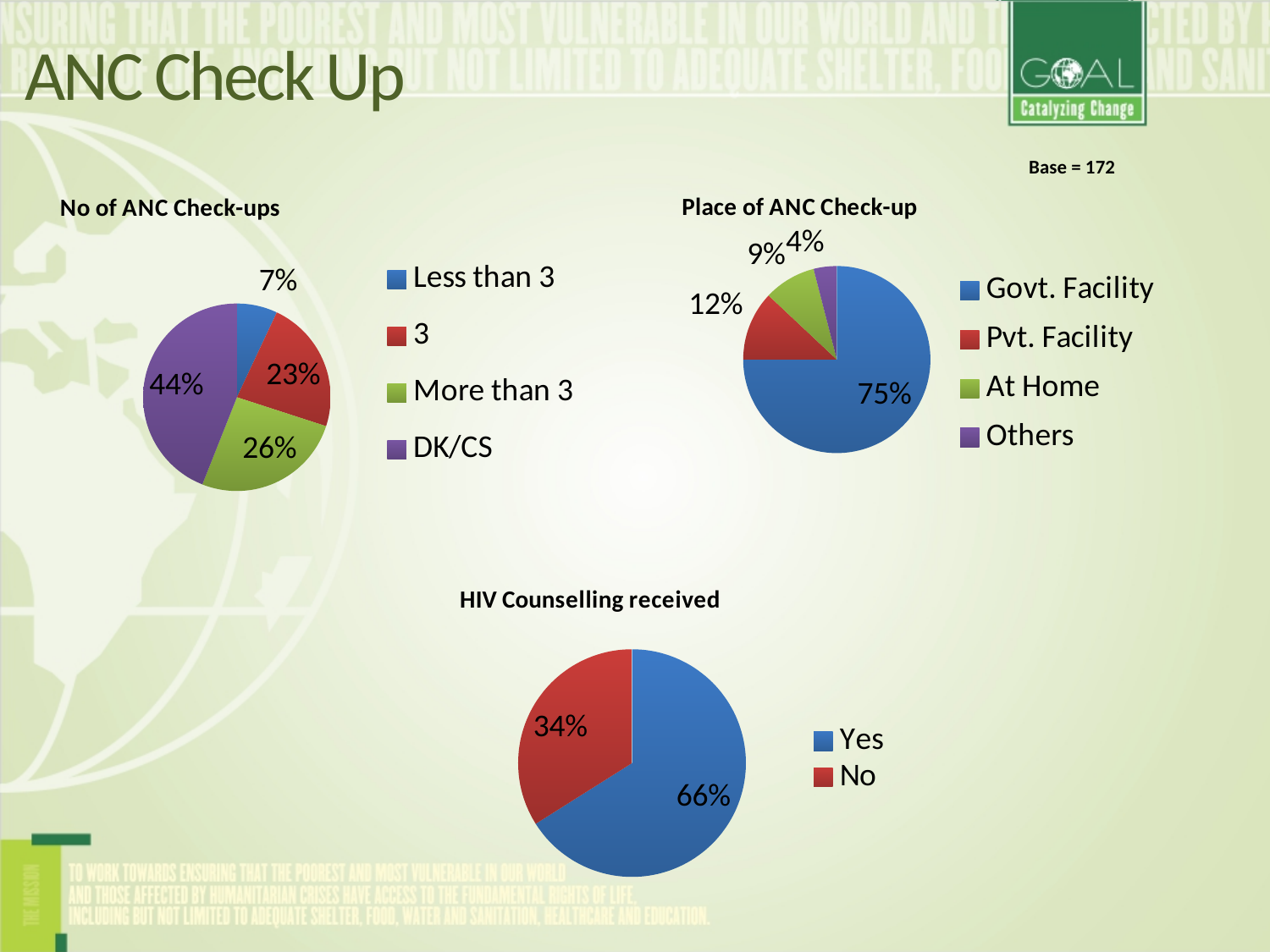
In the 'Place of ANC Check-up' chart, what share is labelled for 'At Home'? 9% In the 'No of ANC Check-ups' chart, what share is labelled for 'Less than 3'? 7% In the 'HIV Counselling received' chart, what share is labelled for 'No'? 34% In the 'No of ANC Check-ups' chart, what share is labelled for 'DK/CS'? 44% In the 'Place of ANC Check-up' chart, which category has the smallest slice? Others In the 'No of ANC Check-ups' chart, what is the difference between the 'More than 3' and '3' slices? 3% What base (sample size) is stated on the slide? Base = 172 What kind of chart is the 'HIV Counselling received' chart? Pie chart In the 'Place of ANC Check-up' chart, what share is labelled for 'Govt. Facility'? 75% In the 'No of ANC Check-ups' chart, which category has the largest slice? DK/CS In the 'Place of ANC Check-up' chart, how many categories does the legend list? 4 In the 'HIV Counselling received' chart, which is larger, 'Yes' or 'No'? Yes